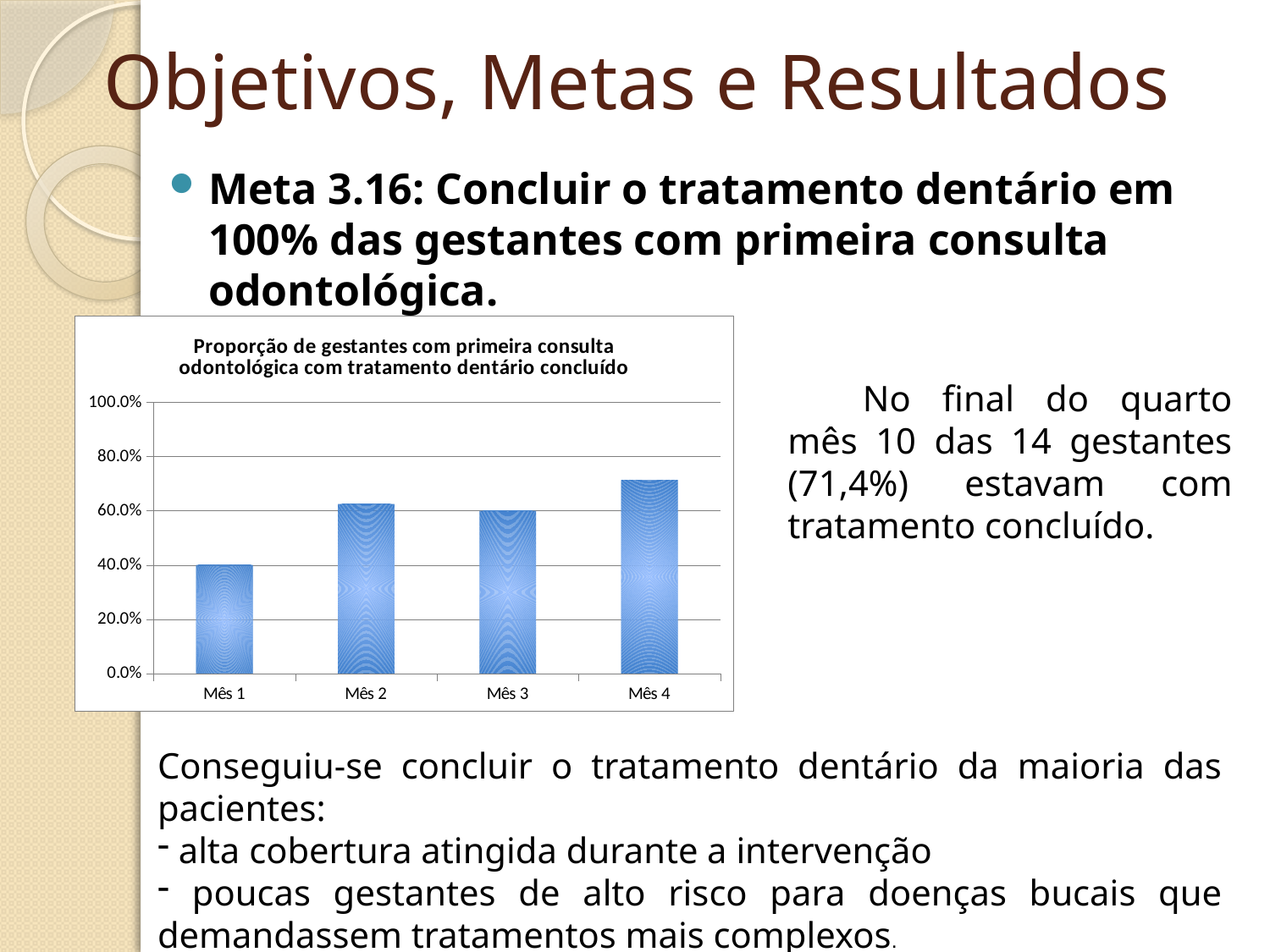
What is the title of the chart? Proporção de gestantes com primeira consulta odontológica com tratamento dentário concluído What kind of chart is shown on the slide? bar chart Is the value for Mês 2 greater or less than 40.0%? greater Which month has the highest proportion in the chart? Mês 4 Is the value for Mês 4 greater or less than 80.0%? less Is the value for Mês 4 greater or less than 60.0%? greater Which is larger, the value for Mês 2 or the value for Mês 1? Mês 2 Which month has the lowest proportion in the chart? Mês 1 How many months (categories) are plotted in the chart? 4 What is the highest value shown on the chart's vertical axis? 100.0% Which is larger, the value for Mês 4 or the value for Mês 1? Mês 4